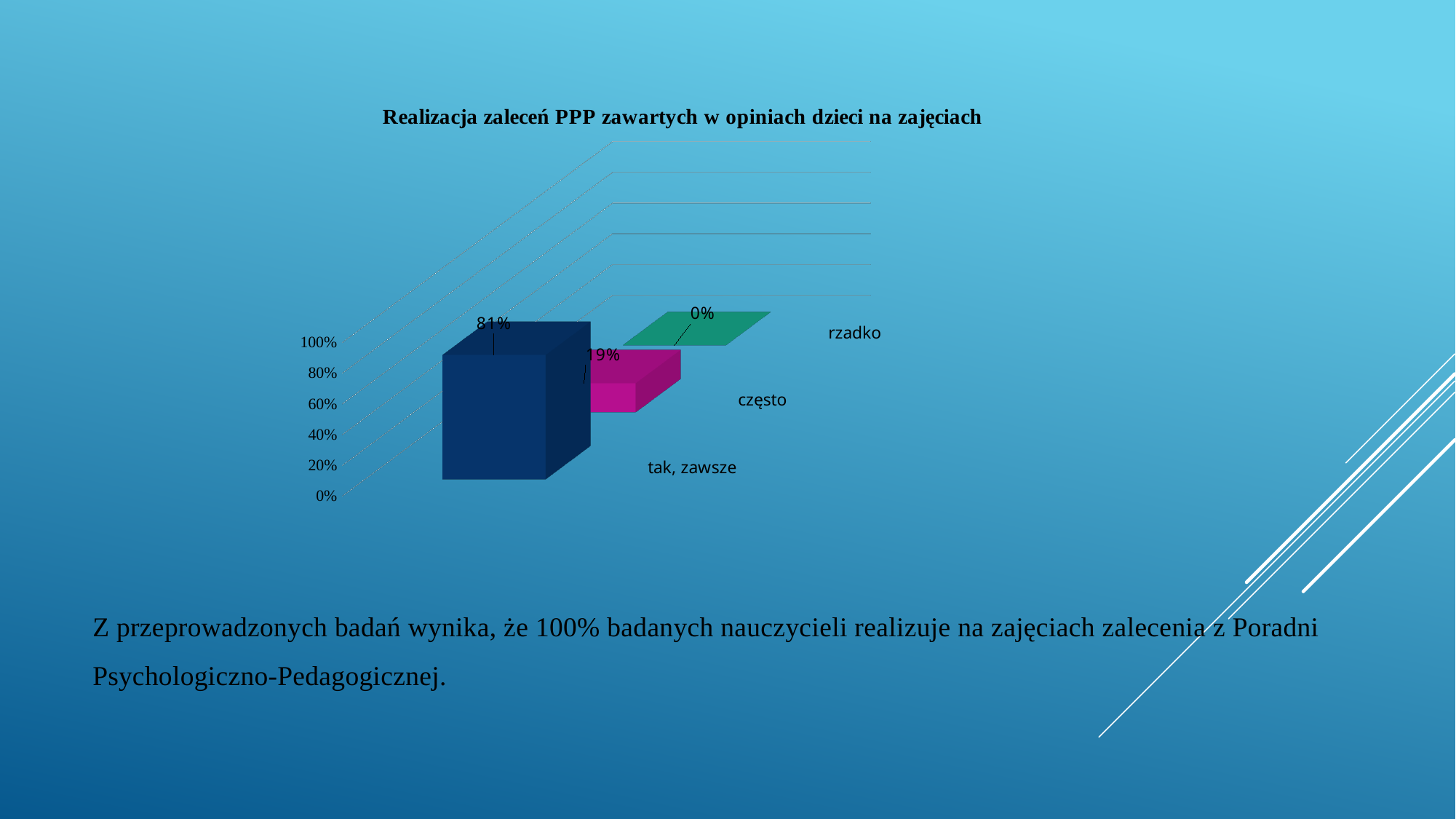
Which category has the highest value? tak, zawsze What is the value for "często"? 19% Which is larger, the value for "często" or the value for "rzadko"? często Which category has the lowest value? rzadko What is the title of the chart? Realizacja zaleceń PPP zawartych w opiniach dzieci na zajęciach Is the value for "tak, zawsze" greater or less than 60%? greater What is the value for "rzadko"? 0% What is the value for "tak, zawsze"? 81% What is the difference between the values for "tak, zawsze" and "często"? 62% What kind of chart is shown on the slide? bar chart How many categories are shown in the chart? 3 Is the value for "często" greater or less than 40%? less